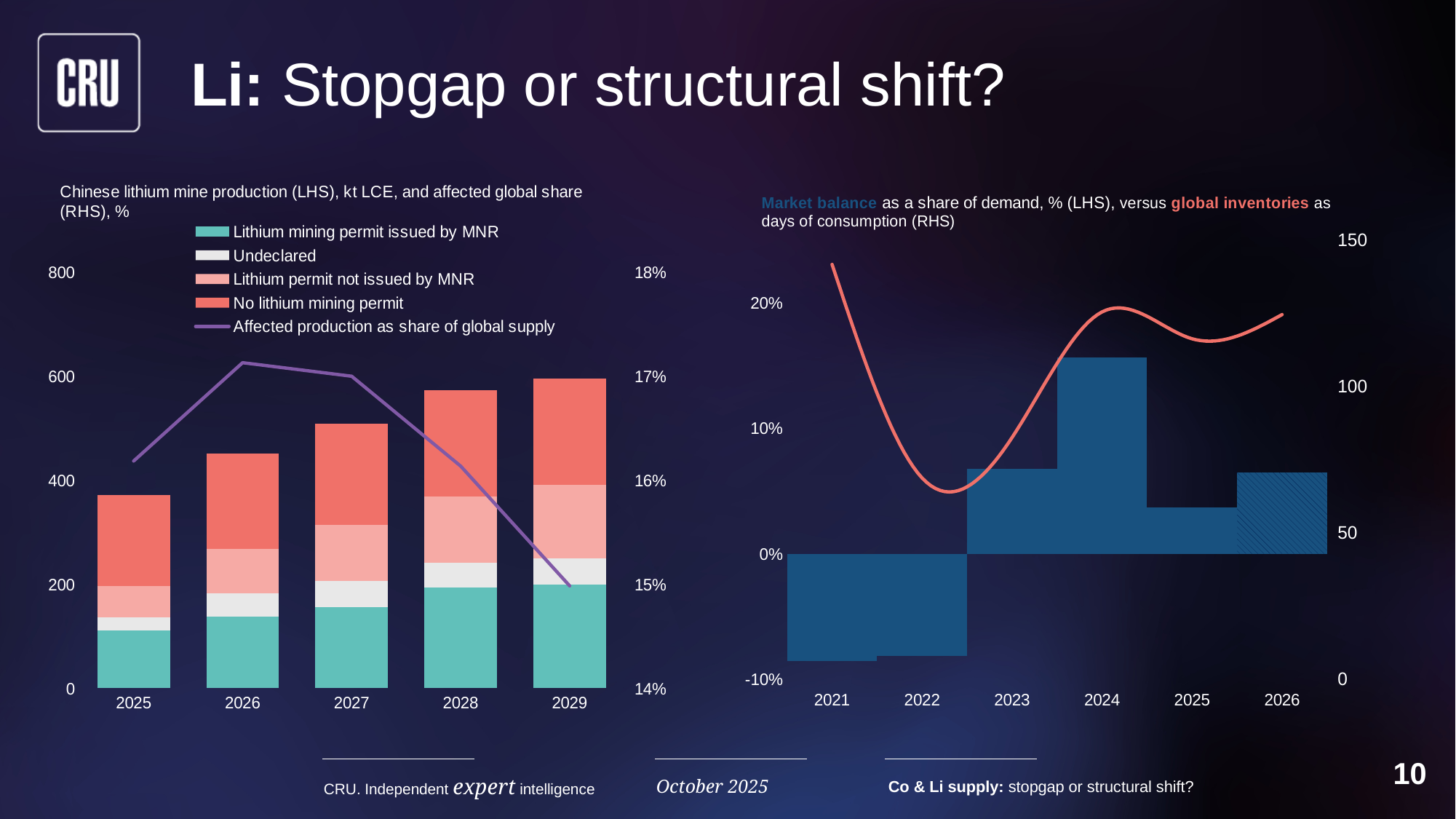
In the left chart (Chinese lithium mine production), which year has the shortest stacked bar? 2025 In the right chart (Market balance versus global inventories), is the market balance for 2021 greater or less than 0%? less In the left chart (Chinese lithium mine production), how many years are shown on the x axis? 5 In the left chart (Chinese lithium mine production), how many entries does the legend list? 5 In the left chart, does the 'Affected production as share of global supply' line rise or fall from 2026 to 2029? fall In the right chart (Market balance versus global inventories), is the global inventories line for 2021 greater or less than 100 days? greater In the right chart (Market balance versus global inventories), how many years are shown on the x axis? 6 What kind of chart is the left chart, 'Chinese lithium mine production (LHS), kt LCE, and affected global share (RHS), %'? Stacked bar chart with a line In the right chart (Market balance versus global inventories), which year has the highest market balance bar? 2024 In the left chart (Chinese lithium mine production), is the total stacked bar for 2028 greater or less than 400? greater In the left chart (Chinese lithium mine production), which year has the tallest stacked bar? 2029